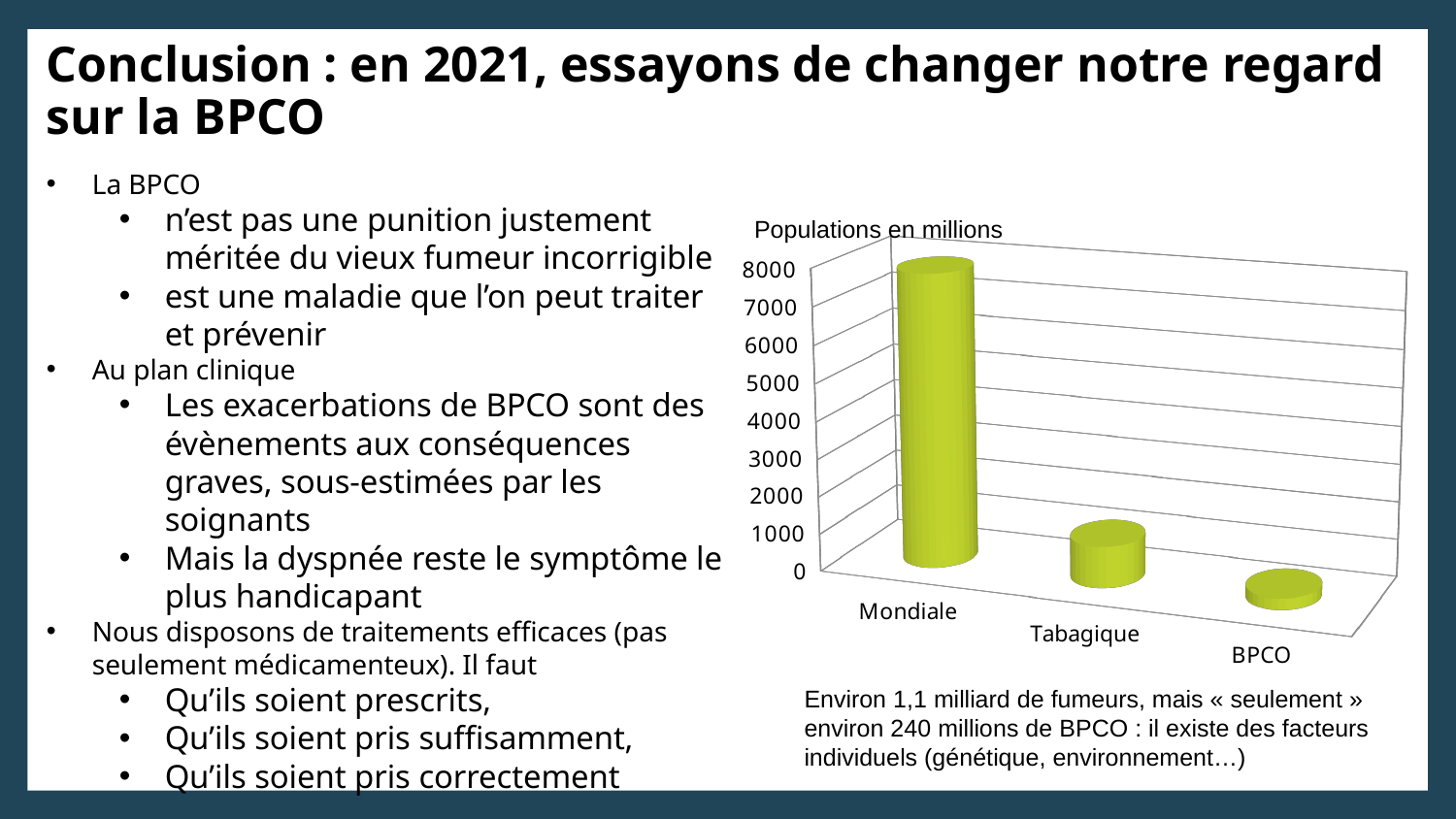
Which is larger, the value for Tabagique or the value for BPCO? Tabagique What is the title of the chart? Populations en millions Which category has the lowest bar in the chart? BPCO Is the value for BPCO greater or less than 1000? less How many categories are plotted in the chart? 3 Is the value for Tabagique greater or less than 2000? less Do the bar values rise or fall from left to right across the categories? fall Is the value for Mondiale greater or less than 6000? greater Which is larger, the value for Mondiale or the value for Tabagique? Mondiale What is the highest value shown on the chart's vertical axis? 8000 Which category has the highest bar in the chart? Mondiale What kind of chart is shown on the slide? bar chart